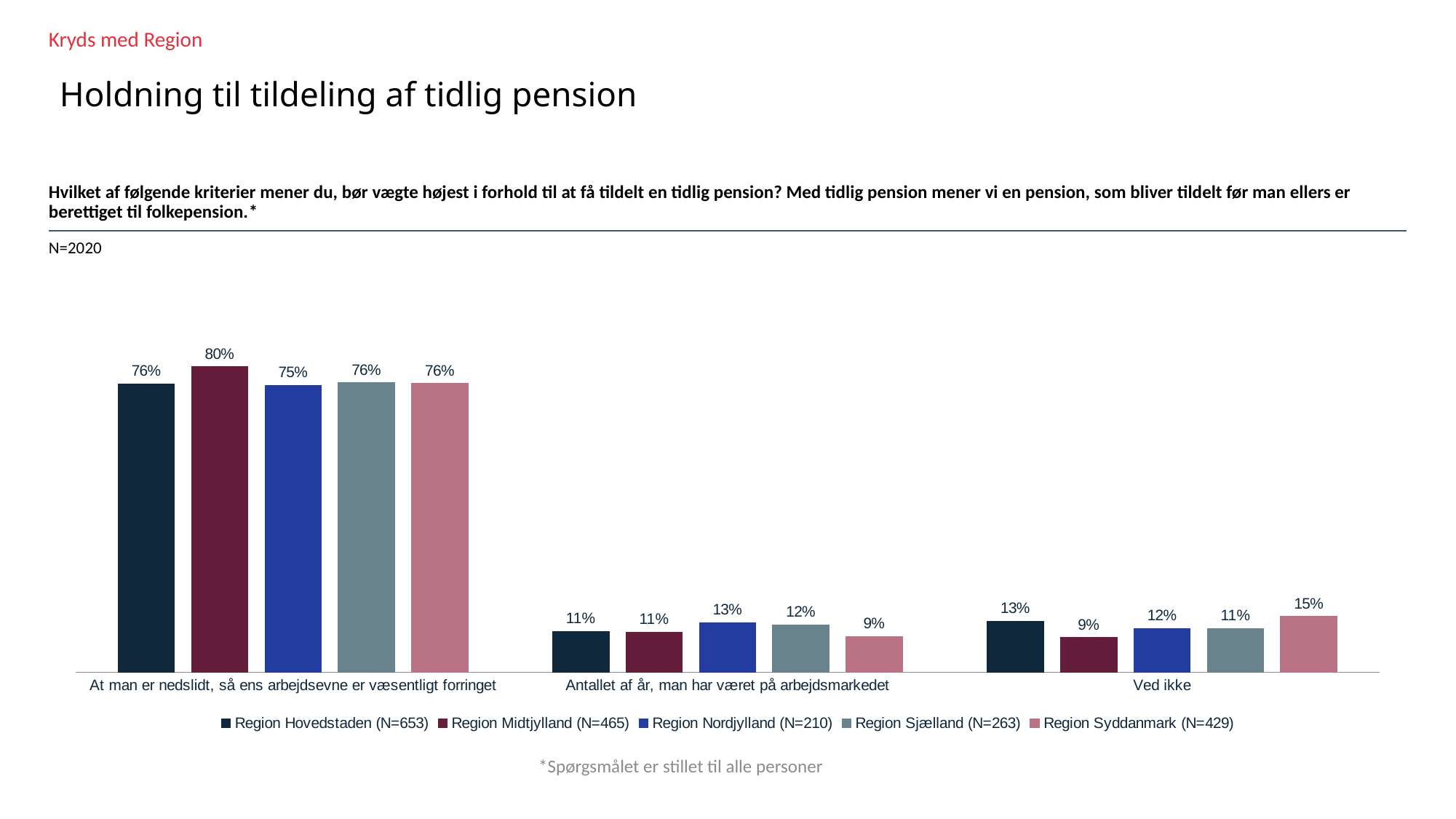
What is the value for Region Syddanmark for 'Antallet af år, man har været på arbejdsmarkedet'? 9% Which region has the highest value for 'At man er nedslidt, så ens arbejdsevne er væsentligt forringet'? Region Midtjylland (N=465) What kind of chart is shown on the slide? Bar chart Which region has the lowest value for 'Ved ikke'? Region Midtjylland (N=465) How many categories are shown on the x axis? 3 How many series does the legend list? 5 What is the difference between Region Midtjylland and Region Nordjylland for 'At man er nedslidt, så ens arbejdsevne er væsentligt forringet'? 5 percentage points Which is larger for 'Antallet af år, man har været på arbejdsmarkedet': Region Nordjylland or Region Syddanmark? Region Nordjylland Which region has the highest value for 'Ved ikke'? Region Syddanmark (N=429) What is the sample size (N) for Region Hovedstaden in the legend? 653 What is the value for Region Nordjylland for 'Ved ikke'? 12% What is the value for Region Midtjylland for 'At man er nedslidt, så ens arbejdsevne er væsentligt forringet'? 80%